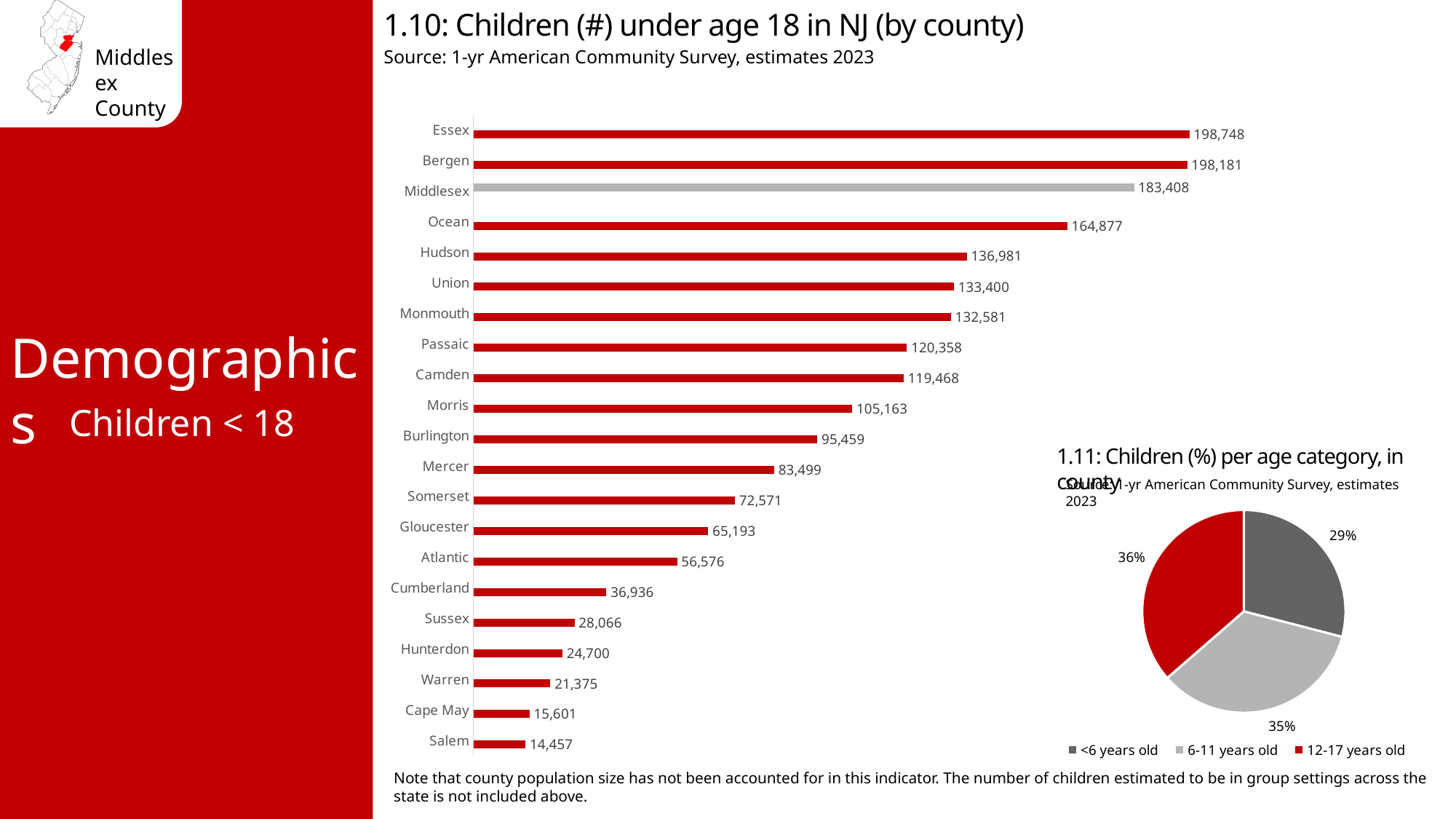
In chart 1.10, what is the value for Hudson? 136,981 In chart 1.10, what is the difference between the values for Middlesex and Ocean? 18,531 In chart 1.11, which age category has the smallest share? <6 years old In chart 1.10, how many children under age 18 are in Middlesex County? 183,408 How many categories does the legend of chart 1.11 list? 3 In chart 1.10, how many counties are shown? 21 In chart 1.10, which county has the lowest number of children under 18? Salem In chart 1.11, what percentage of children are 6-11 years old? 35% In chart 1.10, which has more children under 18, Passaic or Camden? Passaic In chart 1.10, which county has the highest number of children under 18? Essex In chart 1.10, which county's bar is coloured grey instead of red? Middlesex What type of chart is chart 1.10? bar chart